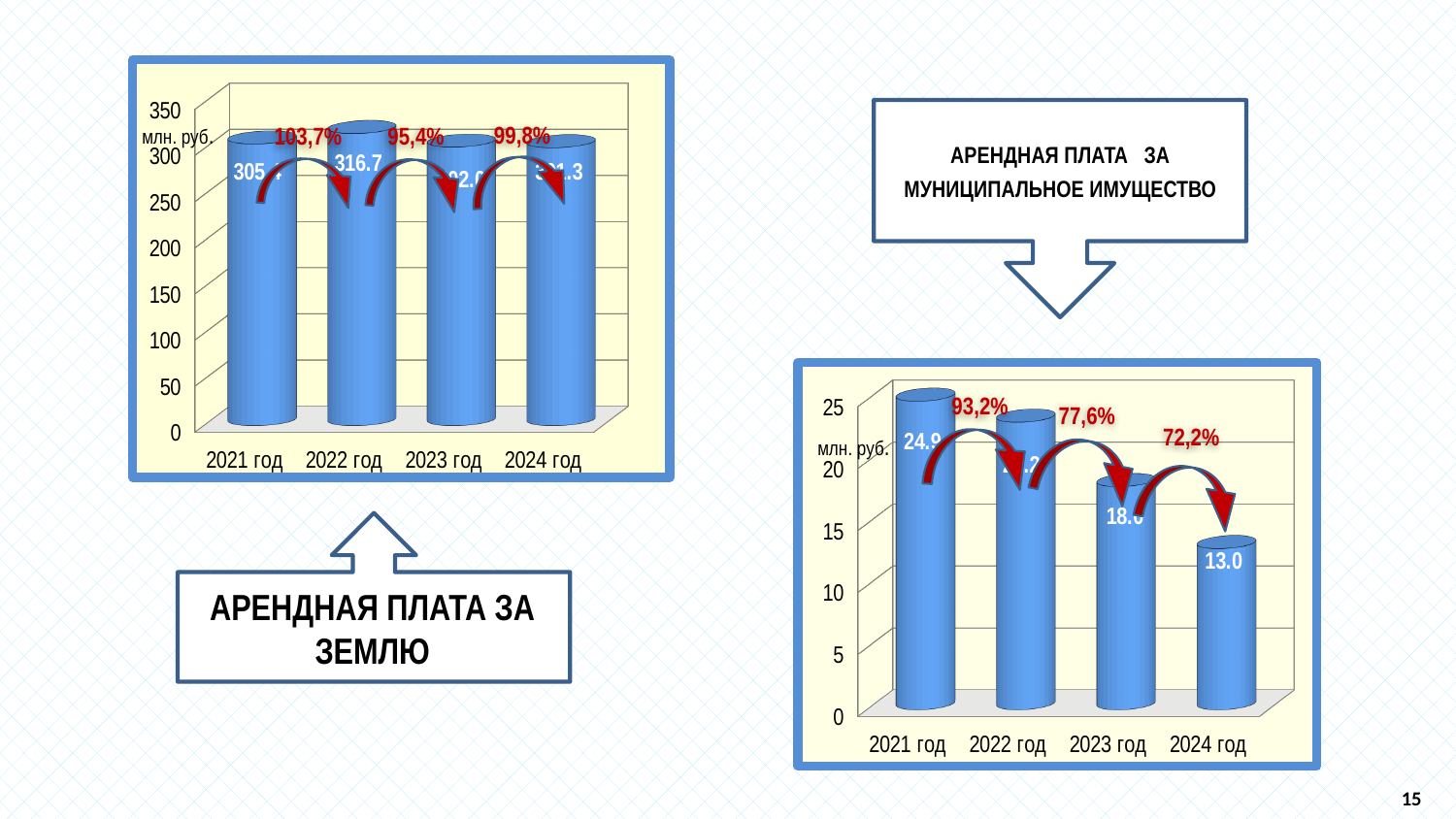
In the chart for 'АРЕНДНАЯ ПЛАТА ЗА МУНИЦИПАЛЬНОЕ ИМУЩЕСТВО' (right), what is the value for 2024 год? 13.0 In the chart for 'АРЕНДНАЯ ПЛАТА ЗА МУНИЦИПАЛЬНОЕ ИМУЩЕСТВО' (right), which year has the highest value? 2021 год How many years are shown on the x axis of the chart for 'АРЕНДНАЯ ПЛАТА ЗА ЗЕМЛЮ' (left)? 4 In the chart for 'АРЕНДНАЯ ПЛАТА ЗА ЗЕМЛЮ' (left), what is the value for 2022 год? 316.7 In the chart for 'АРЕНДНАЯ ПЛАТА ЗА МУНИЦИПАЛЬНОЕ ИМУЩЕСТВО' (right), which year has the lowest value? 2024 год In the chart for 'АРЕНДНАЯ ПЛАТА ЗА МУНИЦИПАЛЬНОЕ ИМУЩЕСТВО' (right), what is the difference between the values for 2021 год and 2024 год? 11.9 In the chart for 'АРЕНДНАЯ ПЛАТА ЗА МУНИЦИПАЛЬНОЕ ИМУЩЕСТВО' (right), do the values rise or fall from 2021 год to 2024 год? fall In the chart for 'АРЕНДНАЯ ПЛАТА ЗА МУНИЦИПАЛЬНОЕ ИМУЩЕСТВО' (right), which is larger, the value for 2022 год or 2023 год? 2022 год In the chart for 'АРЕНДНАЯ ПЛАТА ЗА МУНИЦИПАЛЬНОЕ ИМУЩЕСТВО' (right), what is the value for 2021 год? 24.9 In the chart for 'АРЕНДНАЯ ПЛАТА ЗА ЗЕМЛЮ' (left), what percentage is shown on the arrow between 2021 год and 2022 год? 103,7% In the chart for 'АРЕНДНАЯ ПЛАТА ЗА МУНИЦИПАЛЬНОЕ ИМУЩЕСТВО' (right), what percentage is shown on the arrow between 2023 год and 2024 год? 72,2% In the chart for 'АРЕНДНАЯ ПЛАТА ЗА ЗЕМЛЮ' (left), is the value for 2023 год greater or less than 250? greater